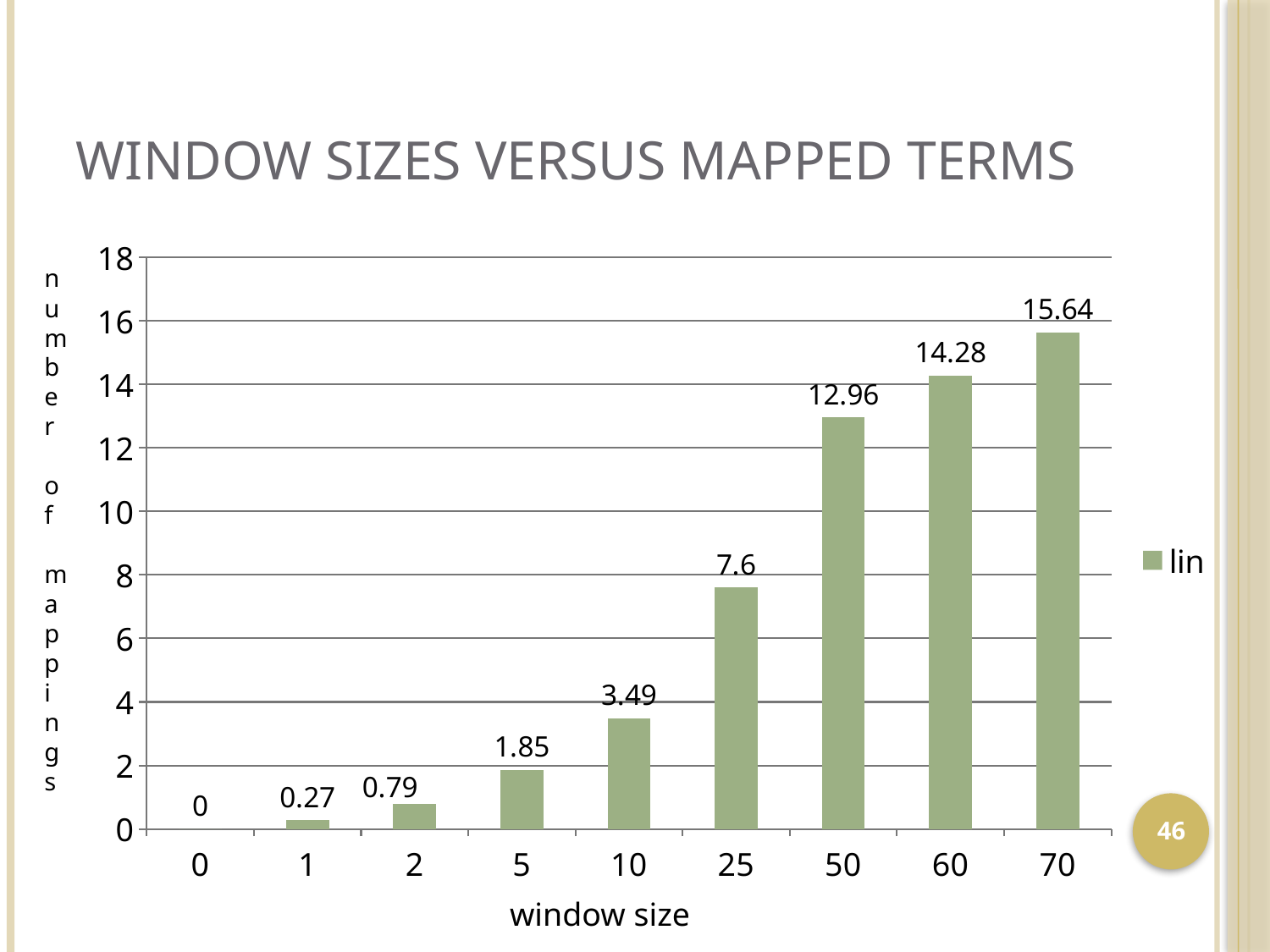
What is the number of mappings for window size 60? 14.28 How many window sizes are shown on the x axis? 9 Do the values rise or fall as window size increases along the x axis? rise Which window size has the highest number of mappings? 70 What is the number of mappings for window size 25? 7.6 What kind of chart is shown on the slide? bar chart How many series does the legend list? 1 Which has more mappings: window size 10 or window size 2? window size 10 Which window size has the lowest number of mappings? 0 What is the number of mappings for window size 5? 1.85 Is the value for window size 50 greater or less than 12? greater What is the difference in number of mappings between window size 70 and window size 50? 2.68